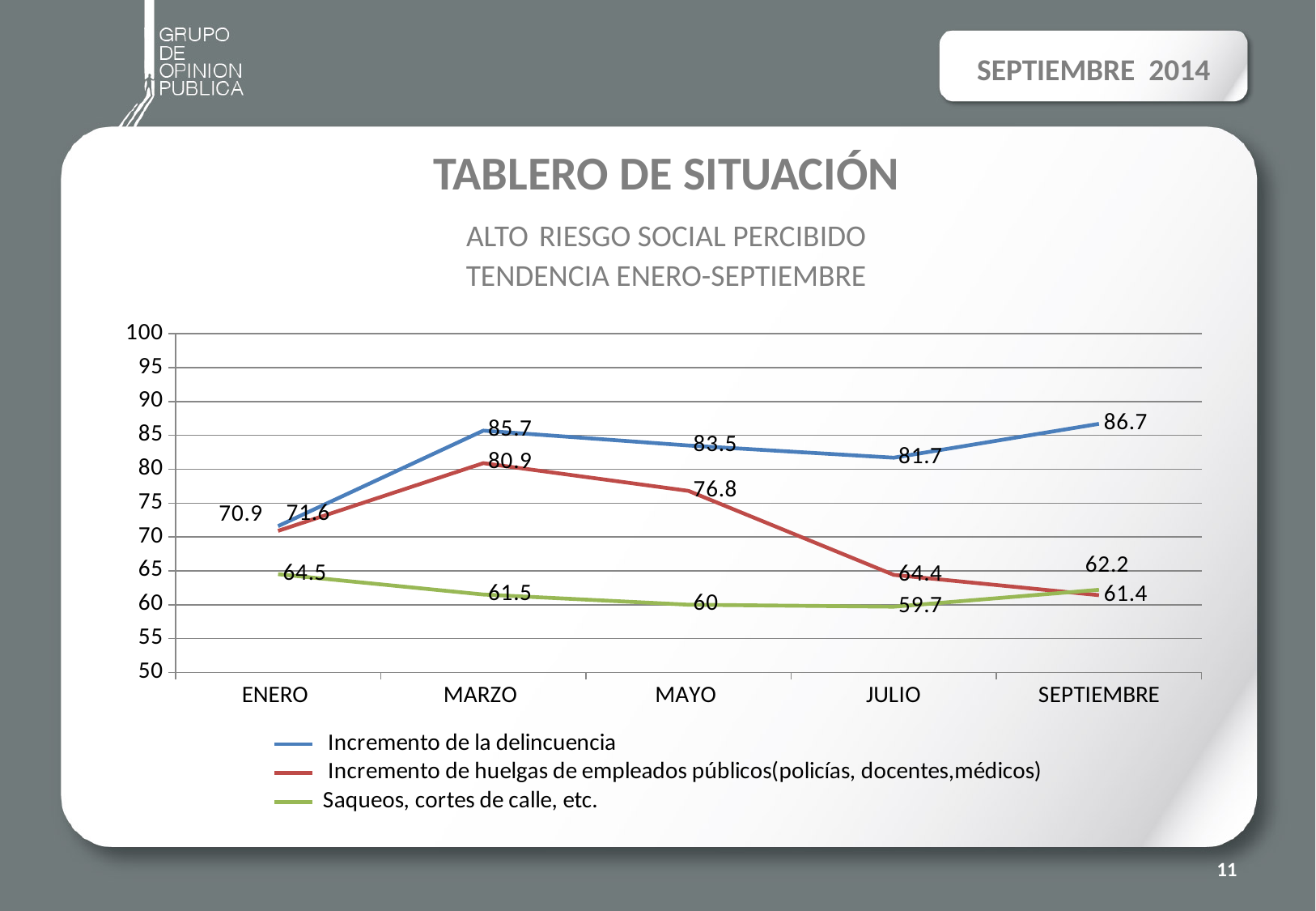
Which is larger in JULIO: Incremento de la delincuencia or Incremento de huelgas de empleados públicos? Incremento de la delincuencia Does Incremento de huelgas de empleados públicos rise or fall from MARZO to SEPTIEMBRE? fall What colour is the line for Saqueos, cortes de calle, etc.? green In which month is Incremento de la delincuencia highest? SEPTIEMBRE In which month is Saqueos, cortes de calle, etc. lowest? JULIO How many series does the legend list? 3 What is the value for Saqueos, cortes de calle, etc. in JULIO? 59.7 What kind of chart is shown on the slide? line chart What is the value for Incremento de huelgas de empleados públicos in MAYO? 76.8 How many months are shown on the x axis? 5 What is the difference between Incremento de huelgas de empleados públicos in MARZO and in SEPTIEMBRE? 19.5 What is the value for Incremento de la delincuencia in SEPTIEMBRE? 86.7